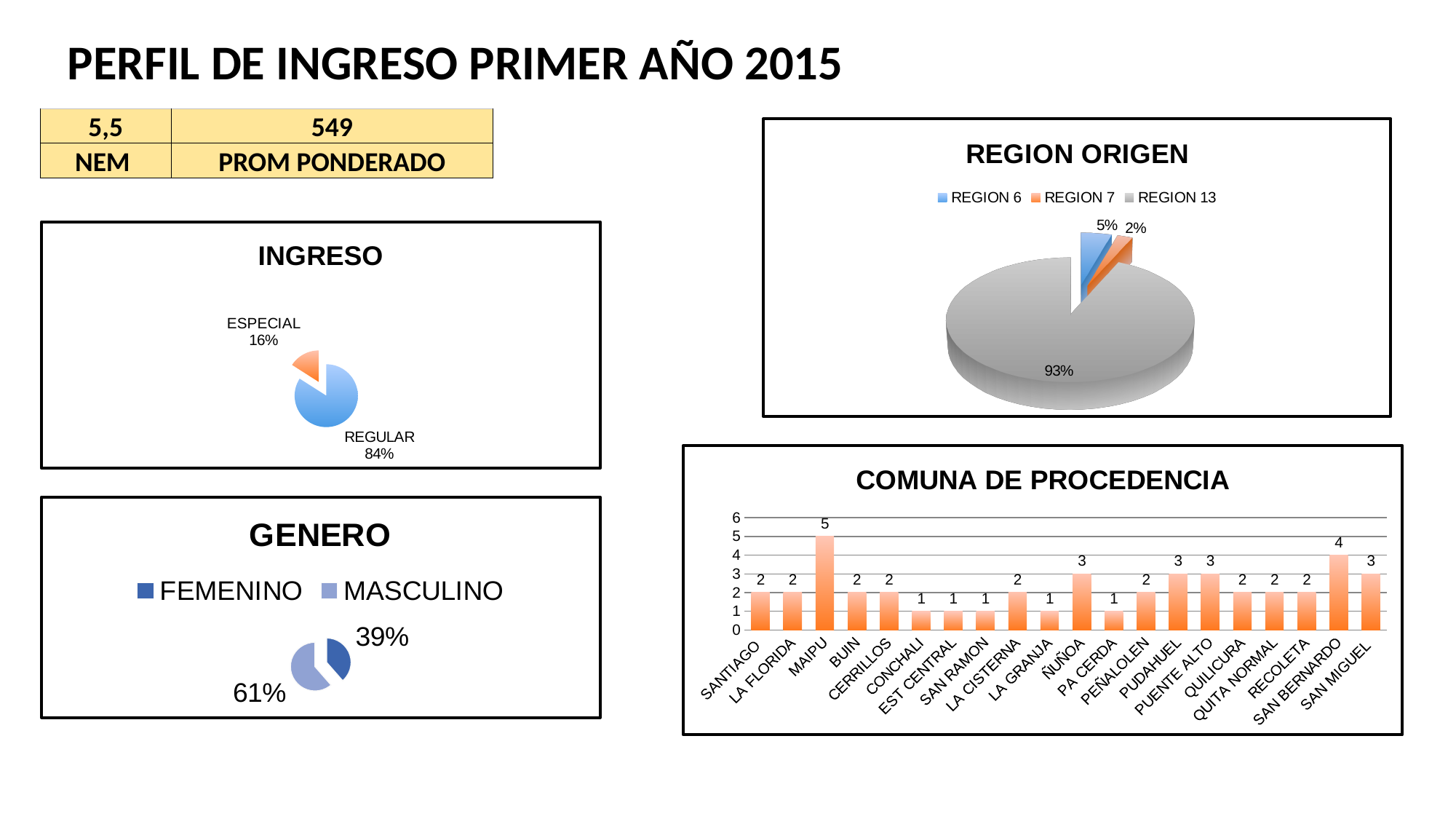
In the INGRESO chart, what share is REGULAR? 84% In the INGRESO chart, what share is ESPECIAL? 16% How many comunas are shown in the COMUNA DE PROCEDENCIA chart? 20 How many series does the legend of the REGION ORIGEN chart list? 3 In the GENERO chart, what share is MASCULINO? 61% In the COMUNA DE PROCEDENCIA chart, what is the value for SAN BERNARDO? 4 In the COMUNA DE PROCEDENCIA chart, which comuna has the highest value? MAIPU In the REGION ORIGEN chart, which region has the smallest share? REGION 7 In the COMUNA DE PROCEDENCIA chart, what is the difference between MAIPU and ÑUÑOA? 2 What kind of chart is the COMUNA DE PROCEDENCIA chart? bar chart In the COMUNA DE PROCEDENCIA chart, which is larger, PUENTE ALTO or RECOLETA? PUENTE ALTO